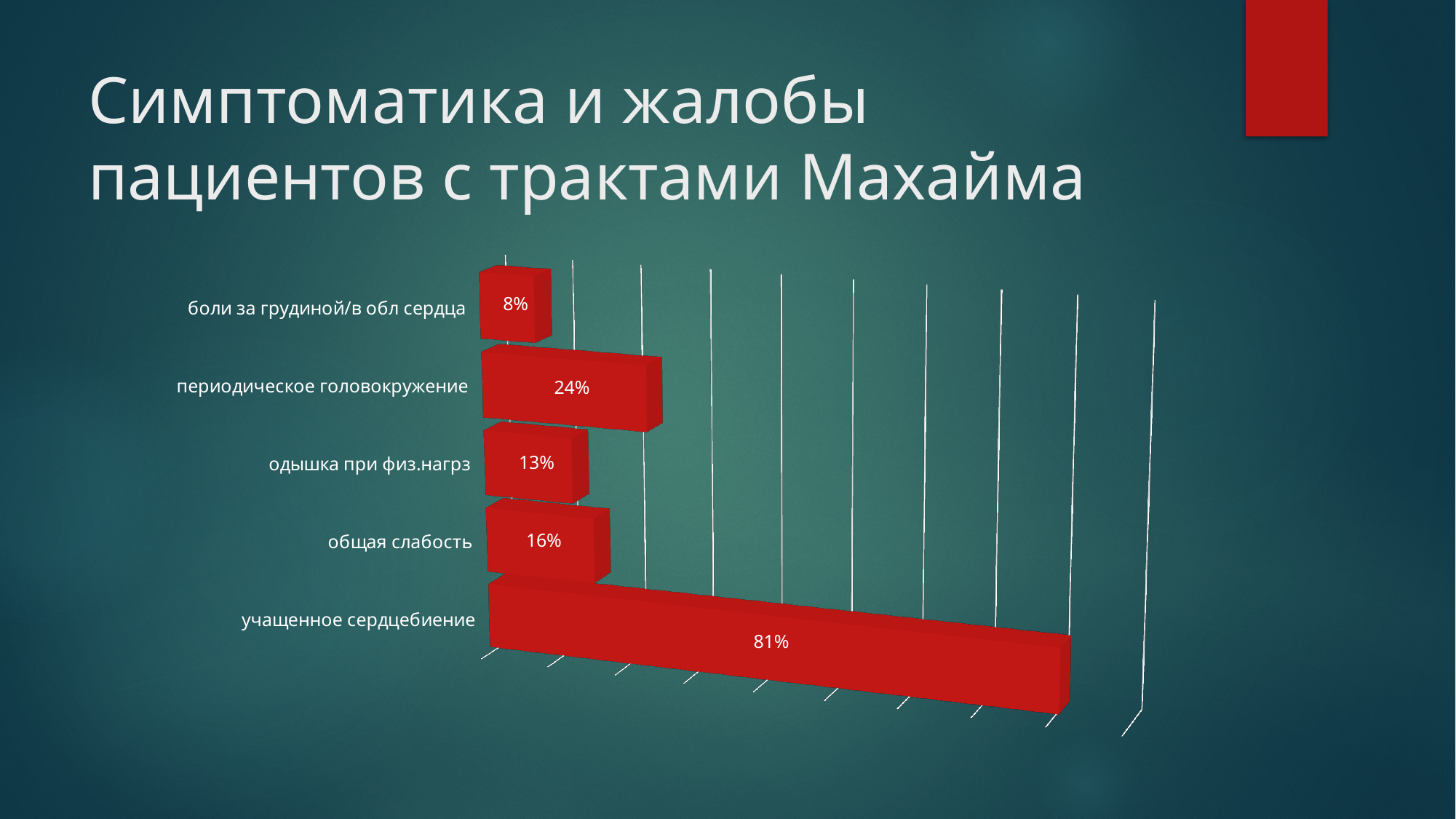
What kind of chart is shown on the slide? bar chart Which category has the highest value? учащенное сердцебиение What is the value for одышка при физ.нагрз? 13% What is the value for учащенное сердцебиение? 81% What is the difference between the values for учащенное сердцебиение and периодическое головокружение? 57% Which category has the lowest value? боли за грудиной/в обл сердца How many categories are shown in the chart? 5 What is the value for боли за грудиной/в обл сердца? 8% What colour are the bars in the chart? red Which is larger, the value for общая слабость or the value for одышка при физ.нагрз? общая слабость What is the value for периодическое головокружение? 24% What is the difference between the values for общая слабость and одышка при физ.нагрз? 3%